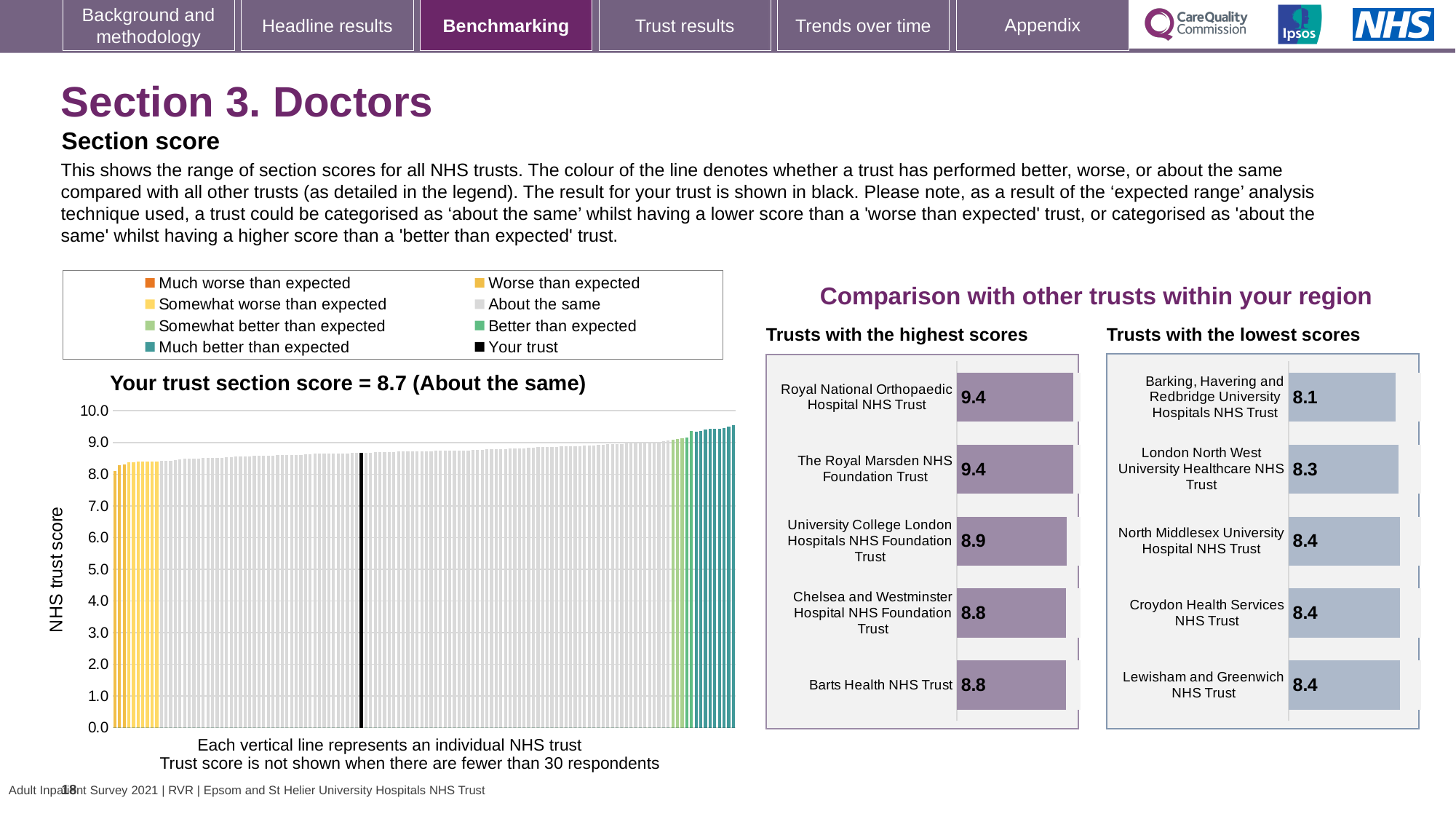
How many entries does the legend above the main chart on the left list? 8 In the main chart on the left, do the trust scores rise or fall from left to right along the x axis? Rise In the 'Trusts with the lowest scores' chart, what is the score for London North West University Healthcare NHS Trust? 8.3 In the 'Trusts with the highest scores' chart, what is the score for Barts Health NHS Trust? 8.8 What kind of chart is the main chart on the left showing NHS trust scores? Bar chart In the 'Trusts with the lowest scores' chart, what is the difference between the score for Croydon Health Services NHS Trust and the score for Barking, Havering and Redbridge University Hospitals NHS Trust? 0.3 In the 'Trusts with the highest scores' chart, which has the larger score: University College London Hospitals NHS Foundation Trust or Chelsea and Westminster Hospital NHS Foundation Trust? University College London Hospitals NHS Foundation Trust In the 'Trusts with the lowest scores' chart, which trust has the lowest score? Barking, Havering and Redbridge University Hospitals NHS Trust How many trusts are listed in the 'Trusts with the lowest scores' chart? 5 In the 'Trusts with the highest scores' chart, what is the difference between the score for Royal National Orthopaedic Hospital NHS Trust and the score for Barts Health NHS Trust? 0.6 What is the section score for your trust shown in the title of the main chart on the left? 8.7 In the 'Trusts with the highest scores' chart, what is the score for University College London Hospitals NHS Foundation Trust? 8.9